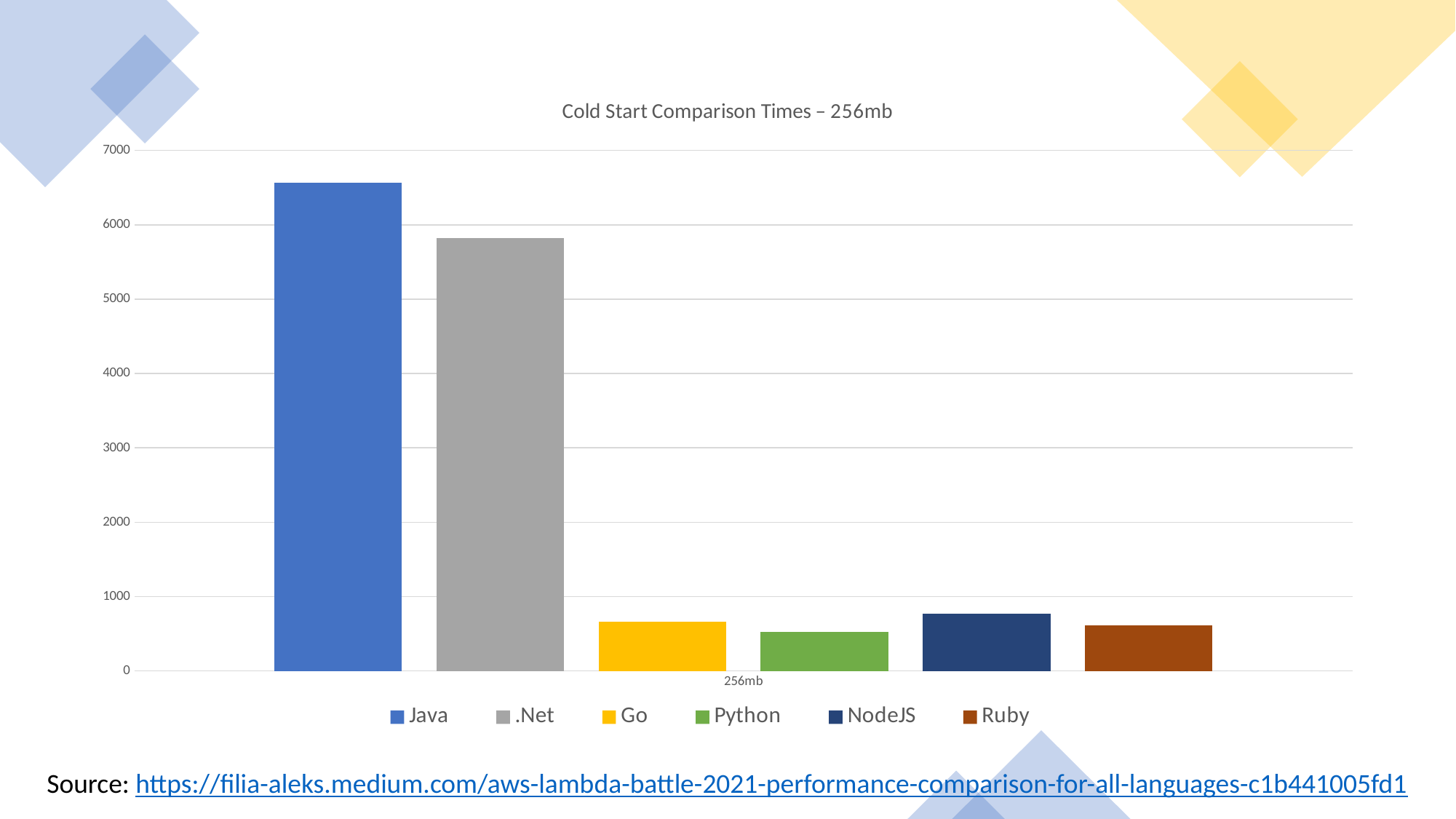
What kind of chart is shown on the slide? Bar chart Is the value for Java greater or less than 6000? greater How many series does the legend list? 6 How many bars are plotted in the chart? 6 Is the value for .Net greater or less than 6000? less Which has the larger value, Python or .Net? .Net What is the title of the chart? Cold Start Comparison Times – 256mb Which language has the highest cold start time in the chart? Java Is the value for .Net greater or less than 5000? greater Which has the larger value, Java or .Net? Java